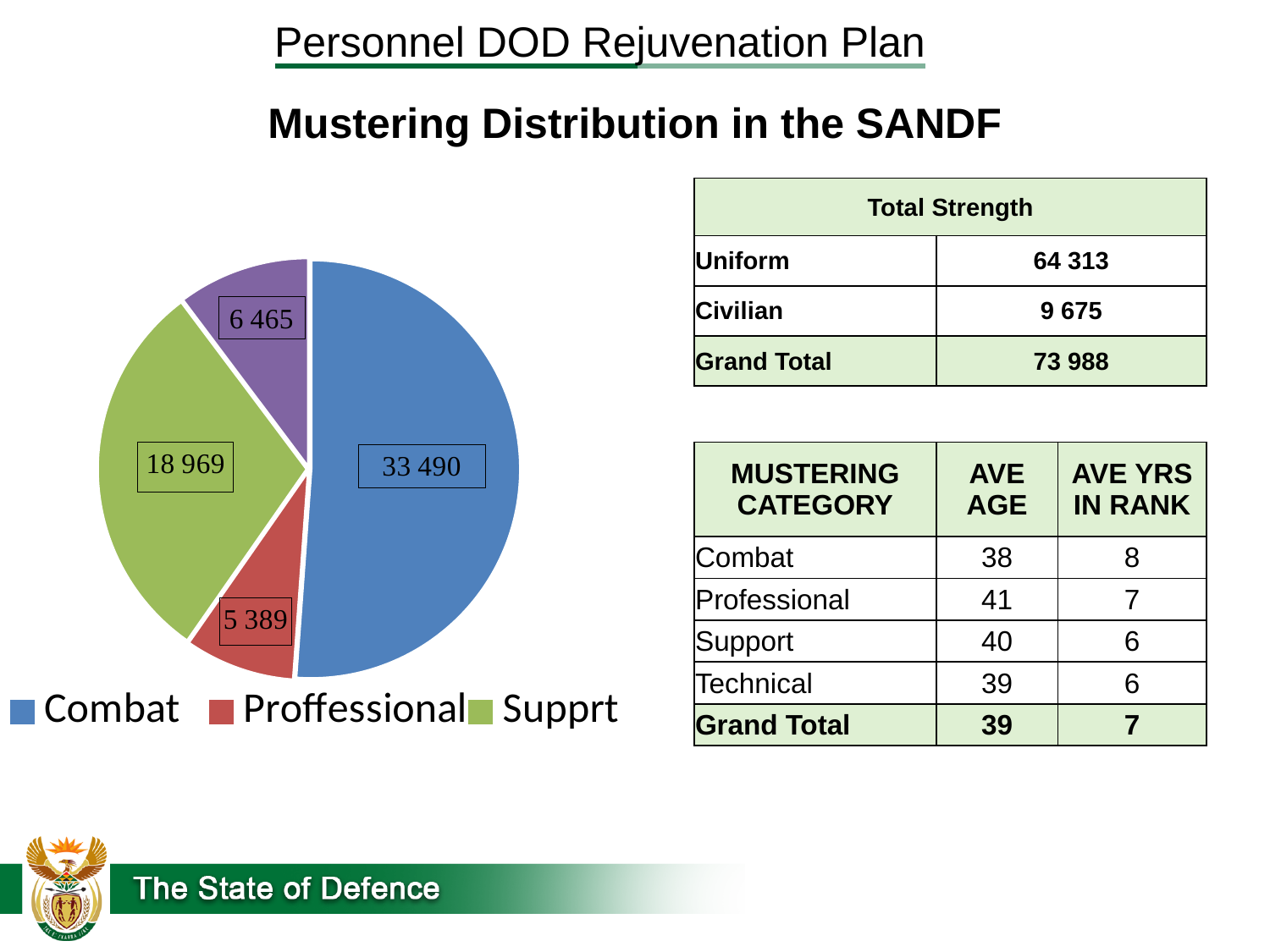
What is the value of the Combat slice in the pie chart? 33 490 What is the value of the Proffessional slice in the pie chart? 5 389 What is the difference between the Supprt value and the Proffessional value in the pie chart? 13 580 Which category has the largest slice in the pie chart? Combat Which category has the smallest slice in the pie chart? Proffessional What is the difference between the Combat value and the Supprt value in the pie chart? 14 521 Which is larger in the pie chart, the Supprt slice or the Proffessional slice? Supprt What colour is the Combat slice in the pie chart? Blue What kind of chart is shown on the slide? Pie chart What is the value of the Supprt slice in the pie chart? 18 969 How many slices does the pie chart have? 4 How many entries does the pie chart's legend list? 3